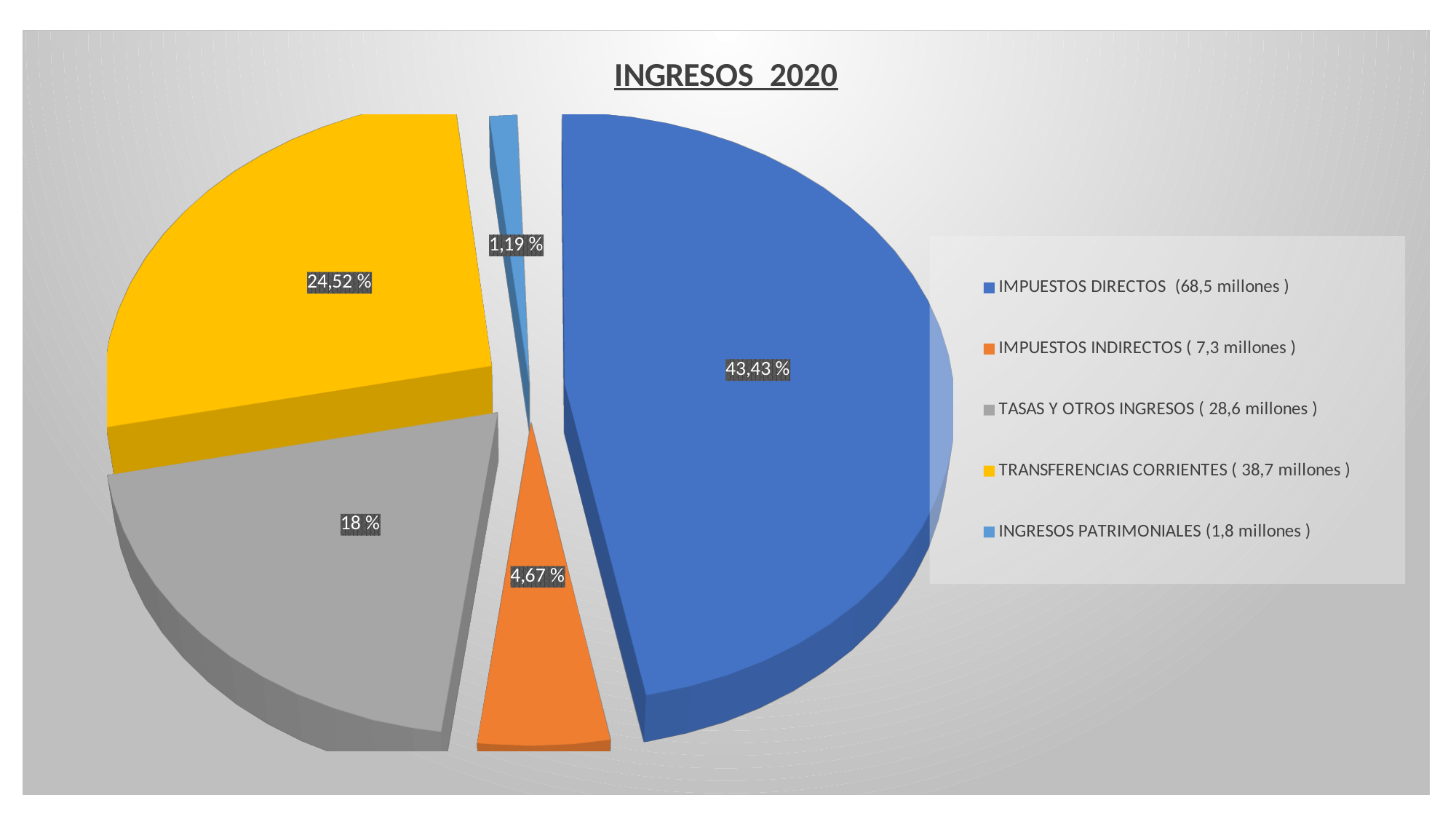
How many categories does the pie chart have? 5 What percentage share does IMPUESTOS DIRECTOS have in the pie? 43,43 % Which category has the largest share of the pie? IMPUESTOS DIRECTOS According to the legend, how many millions does IMPUESTOS DIRECTOS amount to? 68,5 millones What percentage share does INGRESOS PATRIMONIALES have in the pie? 1,19 % What type of chart is shown on the slide? pie chart Which is larger, the share for TRANSFERENCIAS CORRIENTES or the share for TASAS Y OTROS INGRESOS? TRANSFERENCIAS CORRIENTES What percentage share does IMPUESTOS INDIRECTOS have in the pie? 4,67 % What percentage share does TASAS Y OTROS INGRESOS have in the pie? 18 % Which category has the smallest share of the pie? INGRESOS PATRIMONIALES What is the title of the chart? INGRESOS 2020 What percentage share does TRANSFERENCIAS CORRIENTES have in the pie? 24,52 %